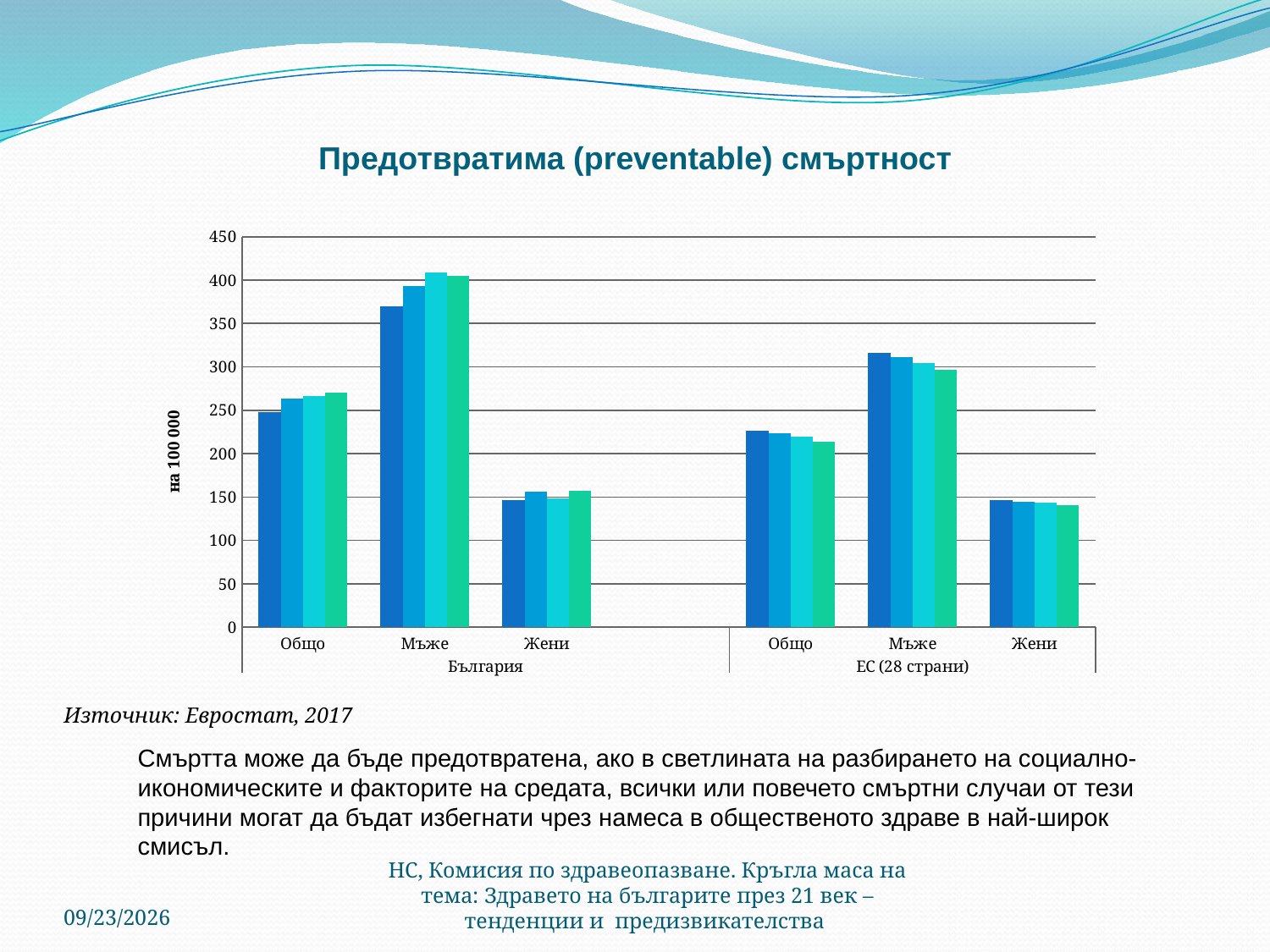
Within the България section, which category has the lowest bars? Жени What kind of chart is shown on the slide? bar chart How many bars are plotted in each category group of the chart? 4 Which category group has the highest bars in the chart? Мъже (България) Are the values for Мъже in България greater or less than 350? greater What is the label on the vertical axis of the chart? на 100 000 How many category groups are shown along the x axis of the chart? 6 Are the values for Мъже in ЕС (28 страни) greater or less than 250? greater Which is larger: the values for Мъже in България or the values for Мъже in ЕС (28 страни)? Мъже in България Within the ЕС (28 страни) section, which category has the lowest bars? Жени Are the values for Общо in ЕС (28 страни) greater or less than 250? less